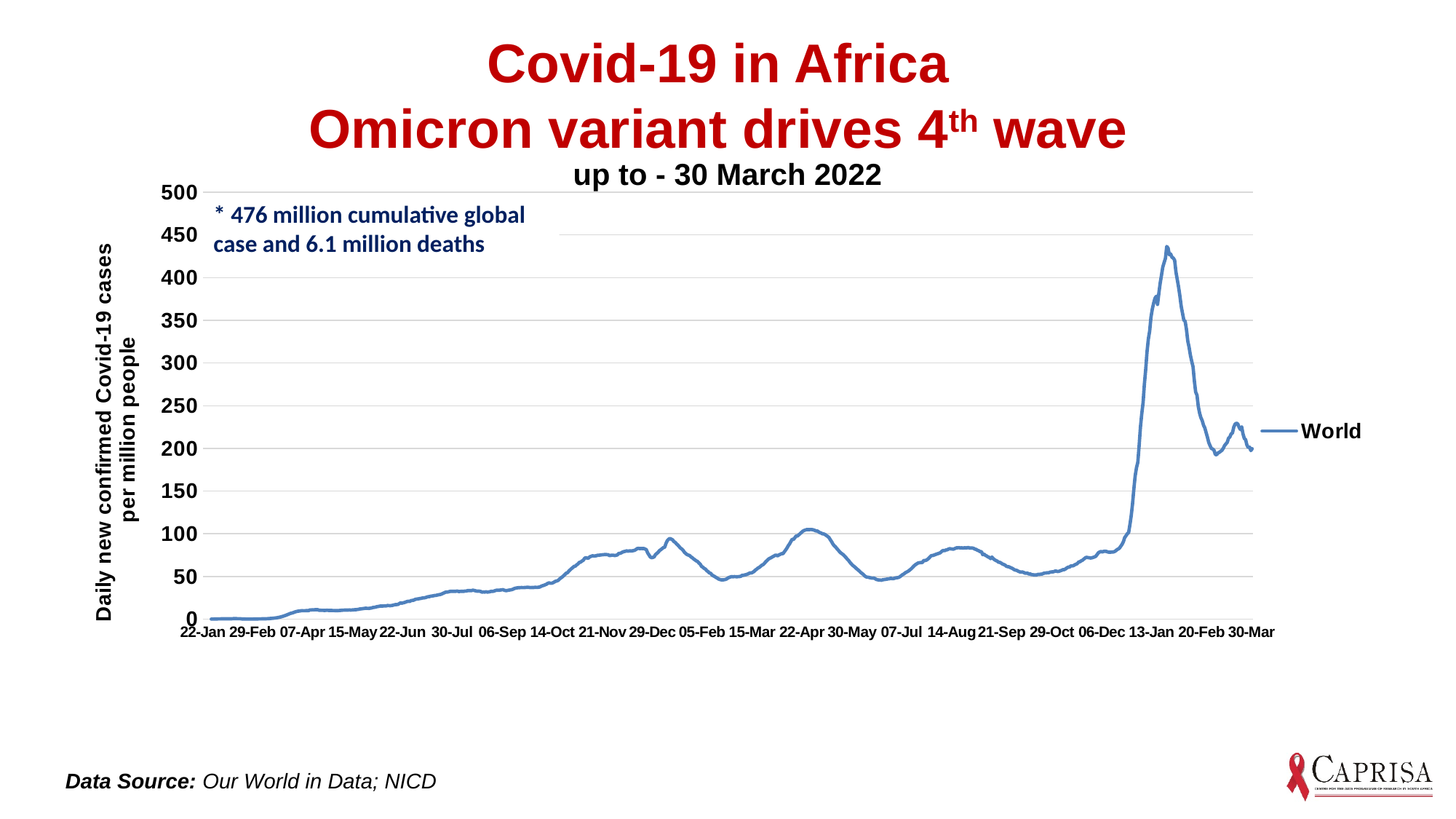
Is the value for World at 30-Mar (the end of the line) greater or less than 150? greater How many series does the legend list? 1 Is the peak value of the World line, around 13-Jan, greater or less than 400? greater Is the value for World at 29-Dec greater or less than 100? less Which is larger, the value for World around 13-Jan or around 22-Apr? 13-Jan What is the name of the series shown in the legend? World What kind of chart is shown on the slide? line chart Near which x-axis date is the World line at its lowest value? 22-Jan Near which x-axis date does the World line reach its highest value? 13-Jan What is the label of the vertical axis? Daily new confirmed Covid-19 cases per million people Does the World line rise or fall between 13-Jan and 20-Feb? fall